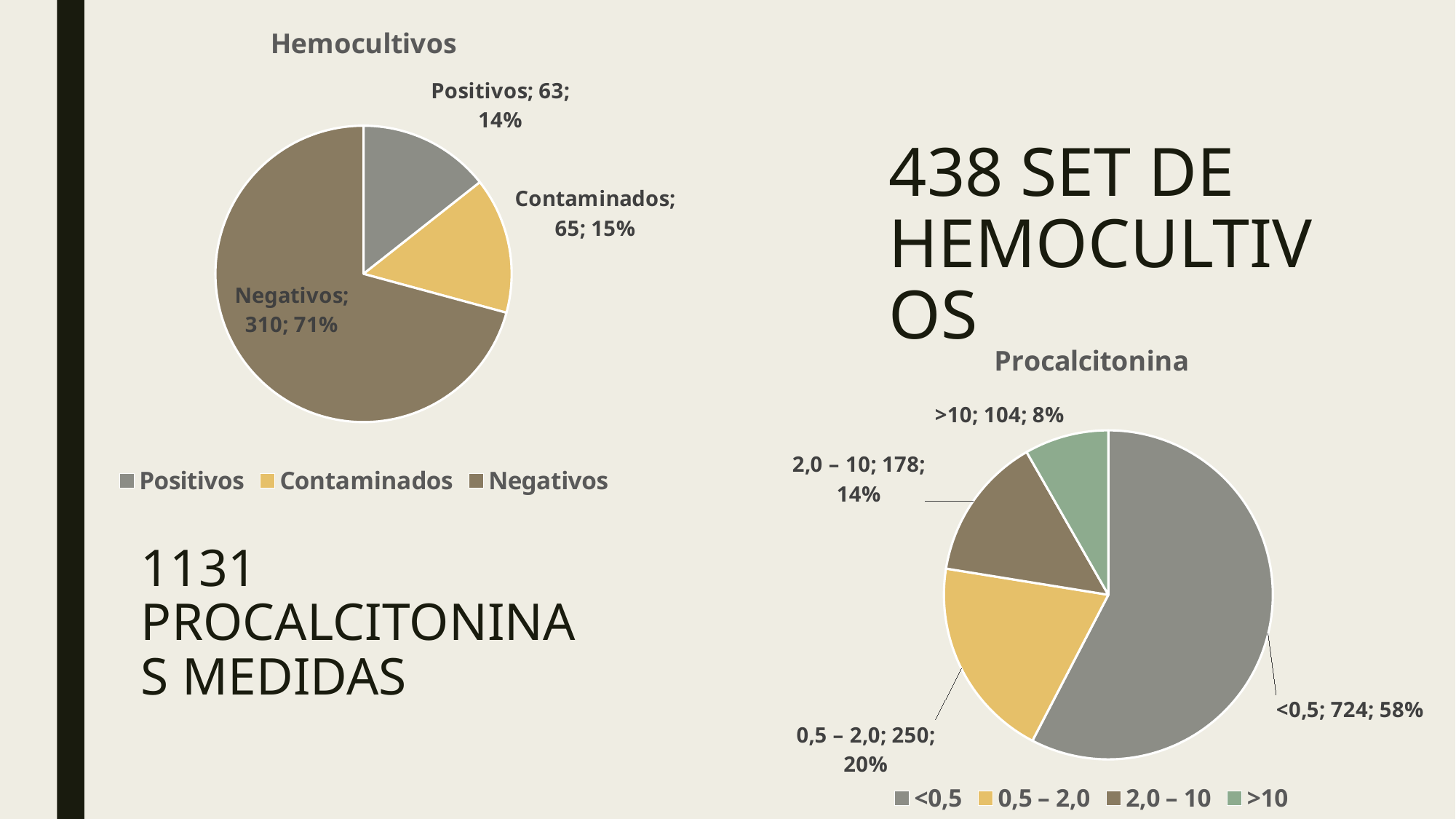
In the Hemocultivos chart, how many categories are shown? 3 In the Hemocultivos chart, which category has the largest slice? Negativos In the Procalcitonina chart, which category has the smallest slice? >10 In the Procalcitonina chart, what is the value for 0,5 – 2,0? 250 In the Procalcitonina chart, how many categories does the legend list? 4 In the Hemocultivos chart, what percentage share is Contaminados? 15% In the Procalcitonina chart, which is larger: 2,0 – 10 or >10? 2,0 – 10 In the Hemocultivos chart, what is the difference between Negativos and Positivos? 247 In the Procalcitonina chart, what percentage share is <0,5? 58% In the Hemocultivos chart, which category has the smallest slice? Positivos What type of chart is the Procalcitonina chart? Pie chart In the Hemocultivos chart, what is the value for Negativos? 310